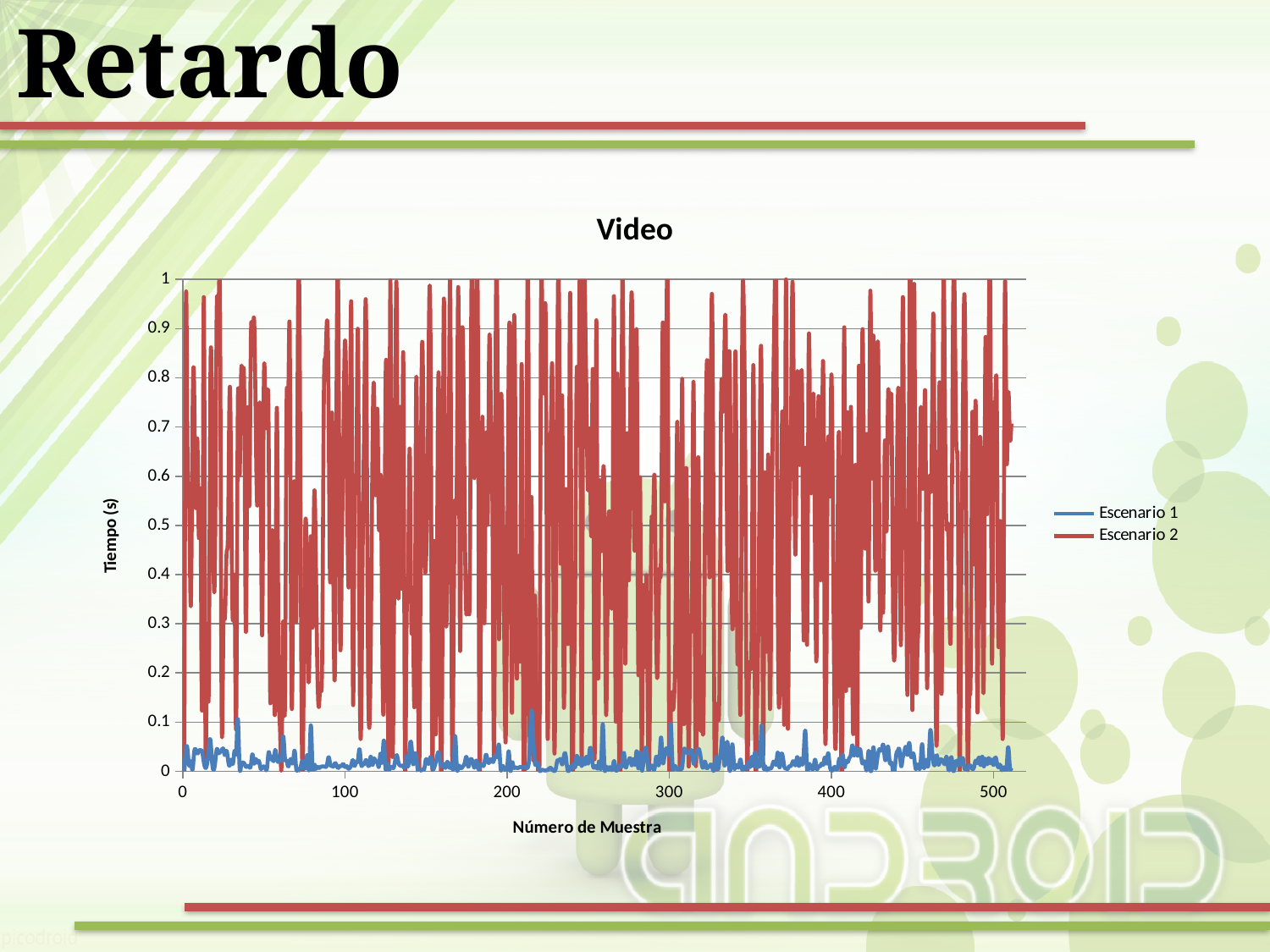
What is the title of the chart? Video What kind of chart is shown on the slide? line chart What are the two series named in the legend? Escenario 1 and Escenario 2 How many series does the legend list? 2 Is the highest value reached by Escenario 1 greater or less than 0.2? less Is the value for Escenario 1 at sample 400 greater or less than 0.2? less Is the value for Escenario 1 at sample 300 greater or less than 0.3? less Which series shows higher delay values overall, Escenario 1 or Escenario 2? Escenario 2 Which series stays at the lowest values throughout the chart? Escenario 1 Which series reaches the highest value on the chart? Escenario 2